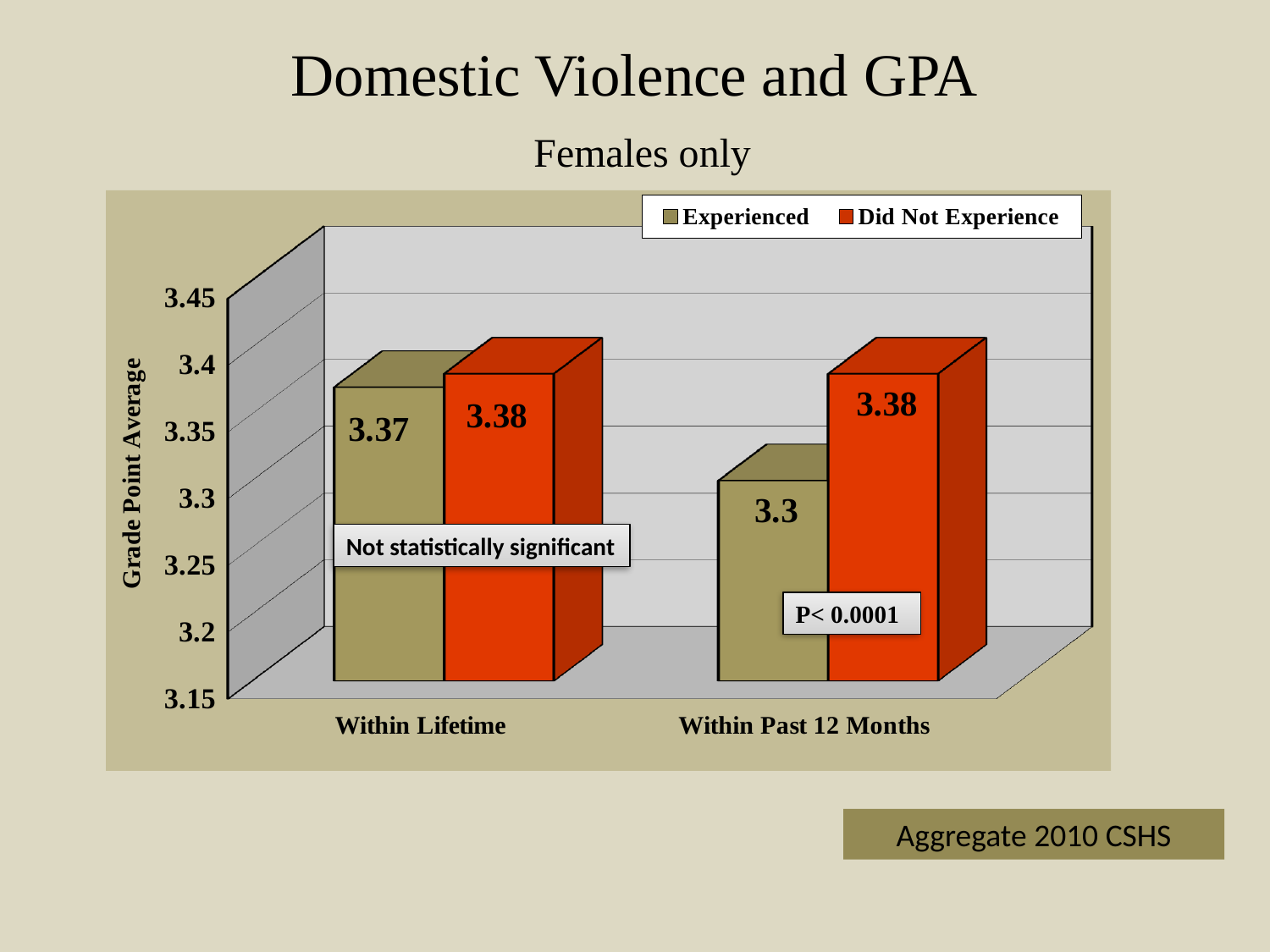
How many series does the legend list? 2 What is the GPA for females who Did Not Experience domestic violence Within Past 12 Months? 3.38 For Within Past 12 Months, which group has the higher GPA, Experienced or Did Not Experience? Did Not Experience What is the GPA for females who Did Not Experience domestic violence Within Lifetime? 3.38 What kind of chart is shown on the slide? Bar chart What is the GPA for females who Experienced domestic violence Within Past 12 Months? 3.3 What is the GPA for females who Experienced domestic violence Within Lifetime? 3.37 What is the difference in GPA between Did Not Experience and Experienced for Within Lifetime? 0.01 What is the label on the vertical axis of the chart? Grade Point Average Which bar shows the lowest GPA on the chart? Experienced, Within Past 12 Months How many categories are shown on the x axis? 2 What is the difference in GPA between Did Not Experience and Experienced for Within Past 12 Months? 0.08